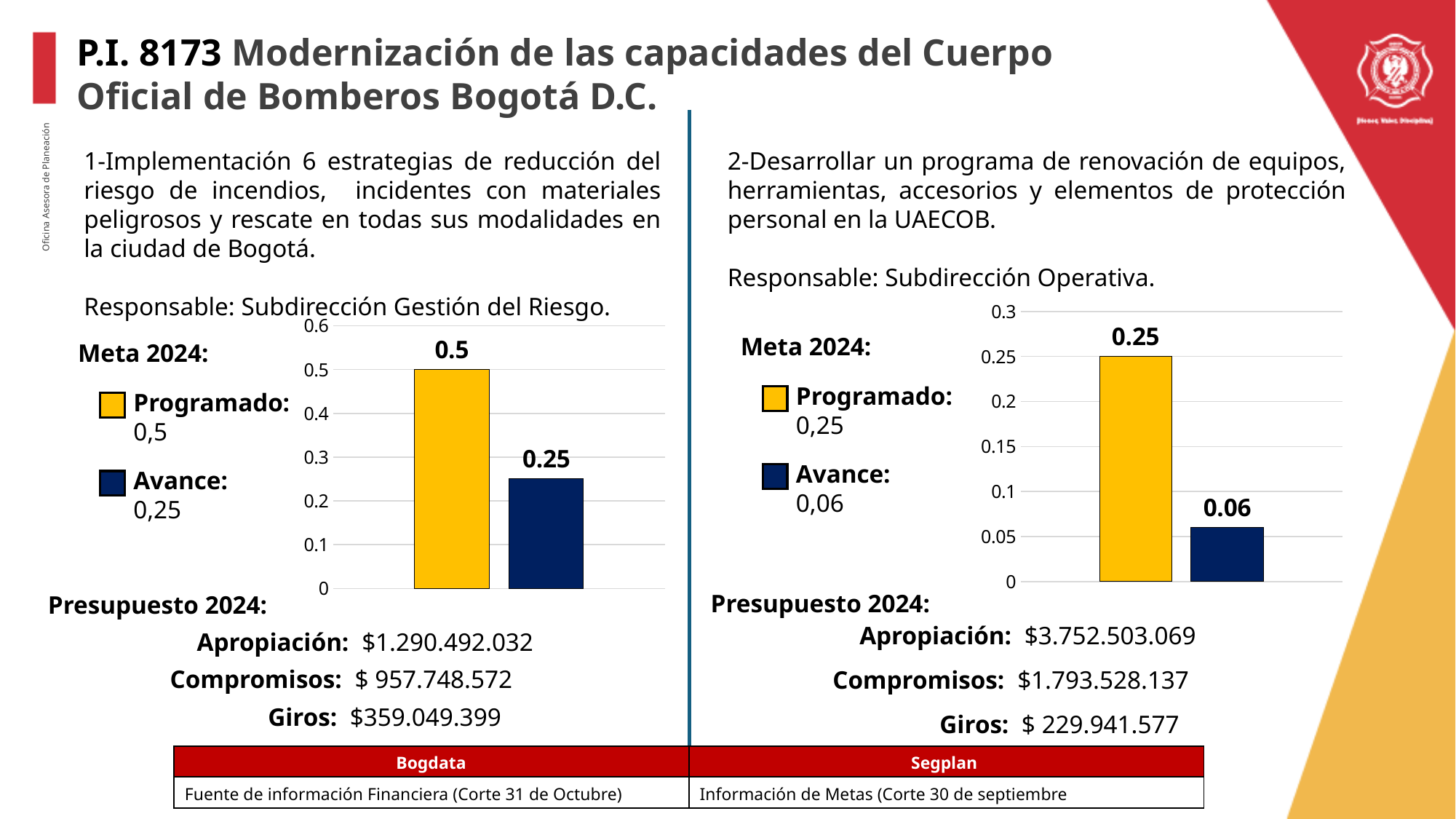
In the right chart, which bar is taller, Programado or Avance? Programado In the left chart, what is the value of the Avance bar? 0.25 In the left chart, what is the difference between the Programado and Avance values? 0.25 In the left chart, which bar has the lowest value? Avance In the right chart, what is the value of the Programado bar? 0.25 In the right chart, what is the difference between the Programado and Avance values? 0.19 In the right chart, what is the value of the Avance bar? 0.06 In the right chart, is the Avance value greater or less than 0.1? less In the left chart, what colour is the Programado bar? Yellow What type of chart is shown on the left side of the slide? Bar chart In the left chart, what is the value of the Programado bar? 0.5 How many bars are plotted in the right chart? 2